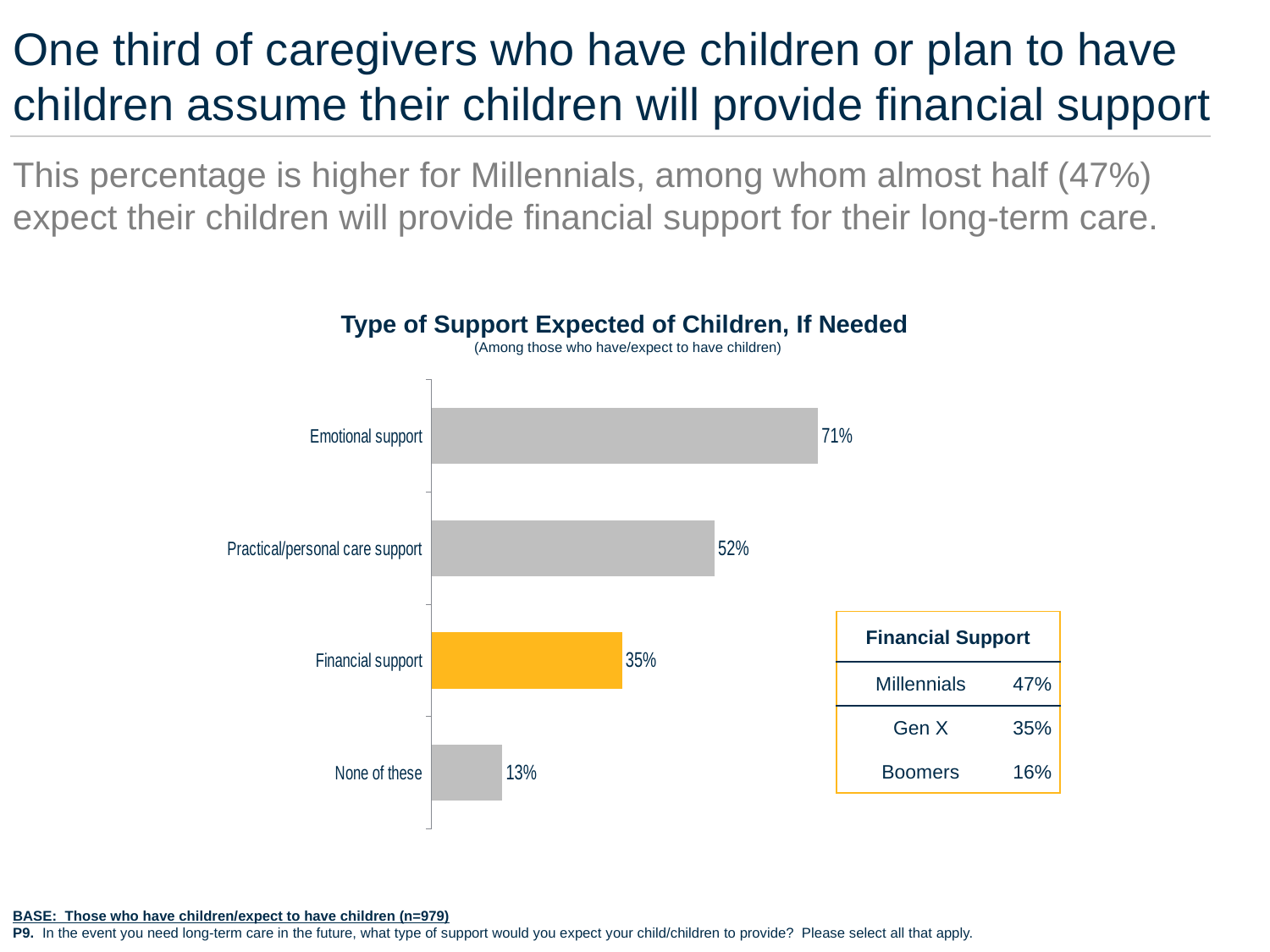
Which category has the lowest value? None of these What is the value for Emotional support? 71% What is the value for Financial support? 35% Which is larger, Practical/personal care support or Financial support? Practical/personal care support Which category has the highest value? Emotional support What kind of chart is this? Bar chart What is the title of the chart? Type of Support Expected of Children, If Needed What is the value for Practical/personal care support? 52% What is the difference between Practical/personal care support and None of these? 39% How many categories are shown in the chart? 4 What is the difference between Emotional support and Financial support? 36% What is the value for None of these? 13%